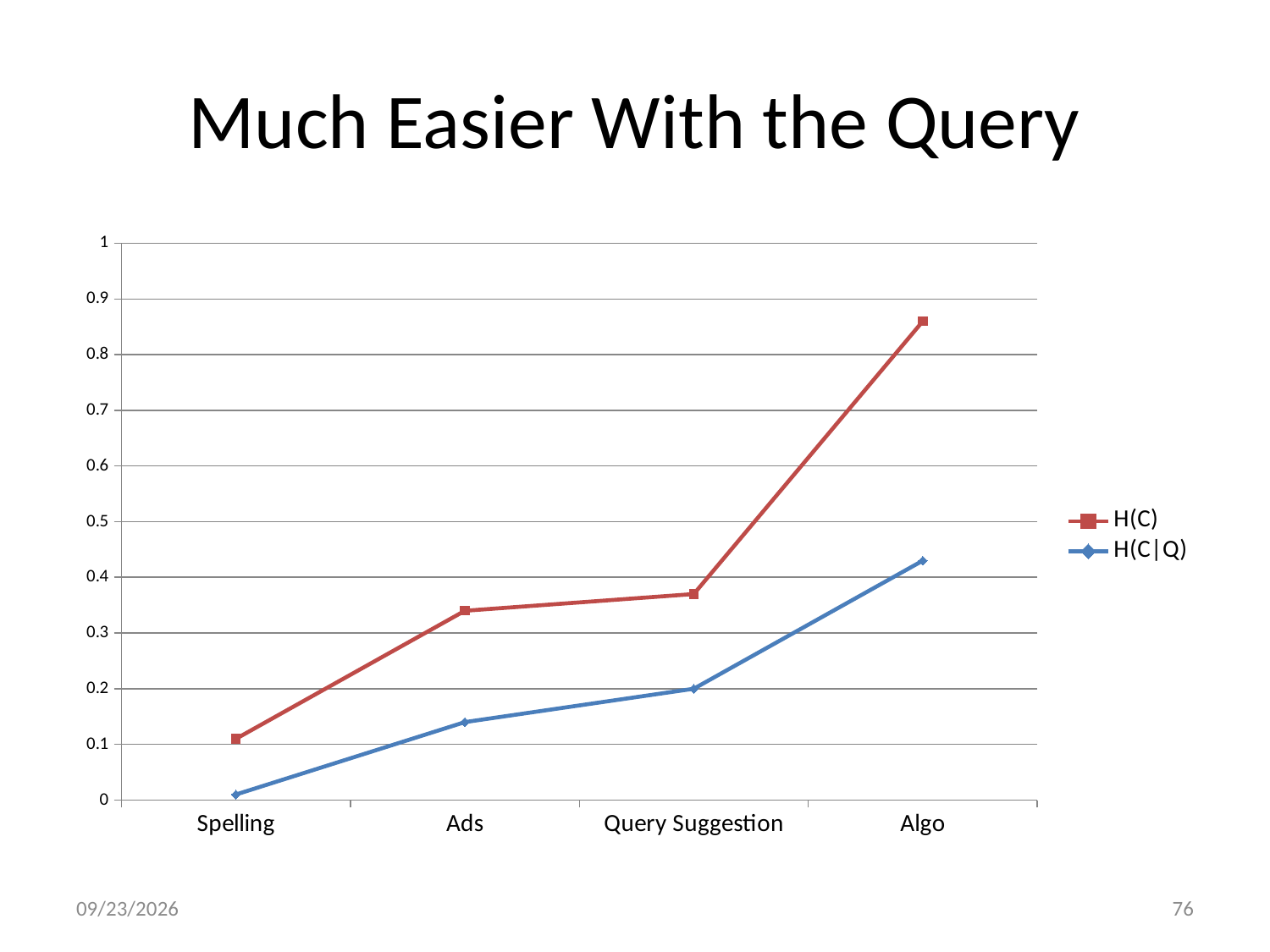
At Algo, which series has the larger value, H(C) or H(C|Q)? H(C) What is the title of the slide containing the chart? Much Easier With the Query Which category has the lowest value for the H(C|Q) series? Spelling Is the value of H(C) for Ads greater or less than 0.3? greater Is the value of H(C) for Algo greater or less than 0.8? greater How many series does the legend list? 2 Which category has the highest value for the H(C) series? Algo Is the value of H(C) for Spelling greater or less than 0.2? less Do the values of the H(C|Q) series rise or fall from Spelling to Algo? rise How many categories are shown on the x axis? 4 What kind of chart is shown on the slide? line chart